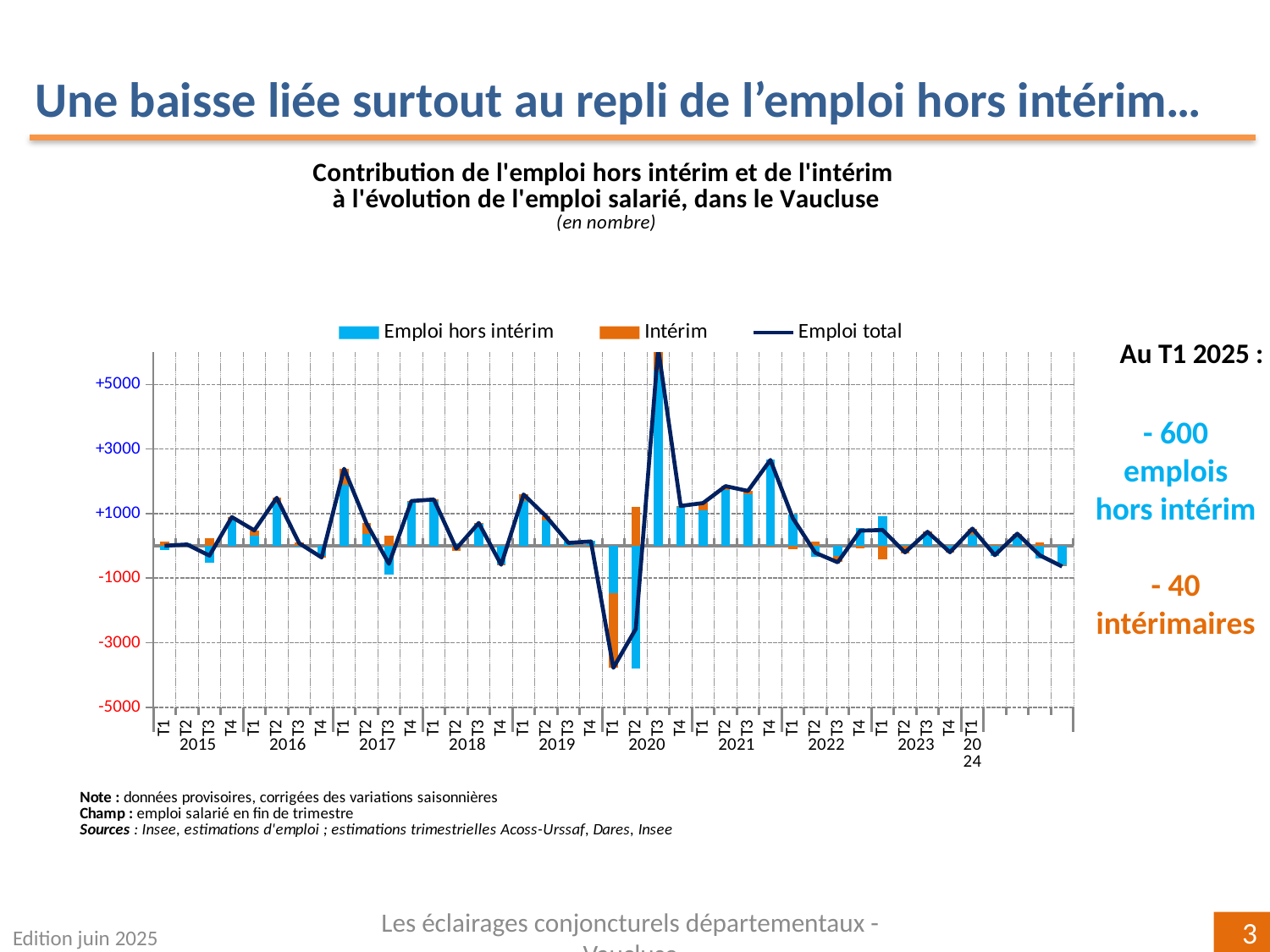
What unit is indicated under the chart title? en nombre Which series is drawn as a line rather than bars? Emploi total How many series does the legend list? 3 According to the annotation on the right, what is the contribution of 'Intérim' at T1 2025? - 40 According to the annotation on the right, what is the contribution of 'Emploi hors intérim' at T1 2025? - 600 What kind of chart is shown on the slide? A combined bar and line chart In which quarter does the 'Emploi total' line reach its highest value? T3 2020 Is the 'Emploi hors intérim' value for T1 2020 greater or less than -3000? greater Is the 'Emploi hors intérim' value for T3 2020 greater or less than +5000? greater In which quarter does the 'Emploi total' line reach its lowest value? T1 2020 Does the 'Emploi total' line rise or fall between T1 2020 and T3 2020? rise Which is larger, the 'Emploi hors intérim' value for T1 2017 or for T1 2018? T1 2017